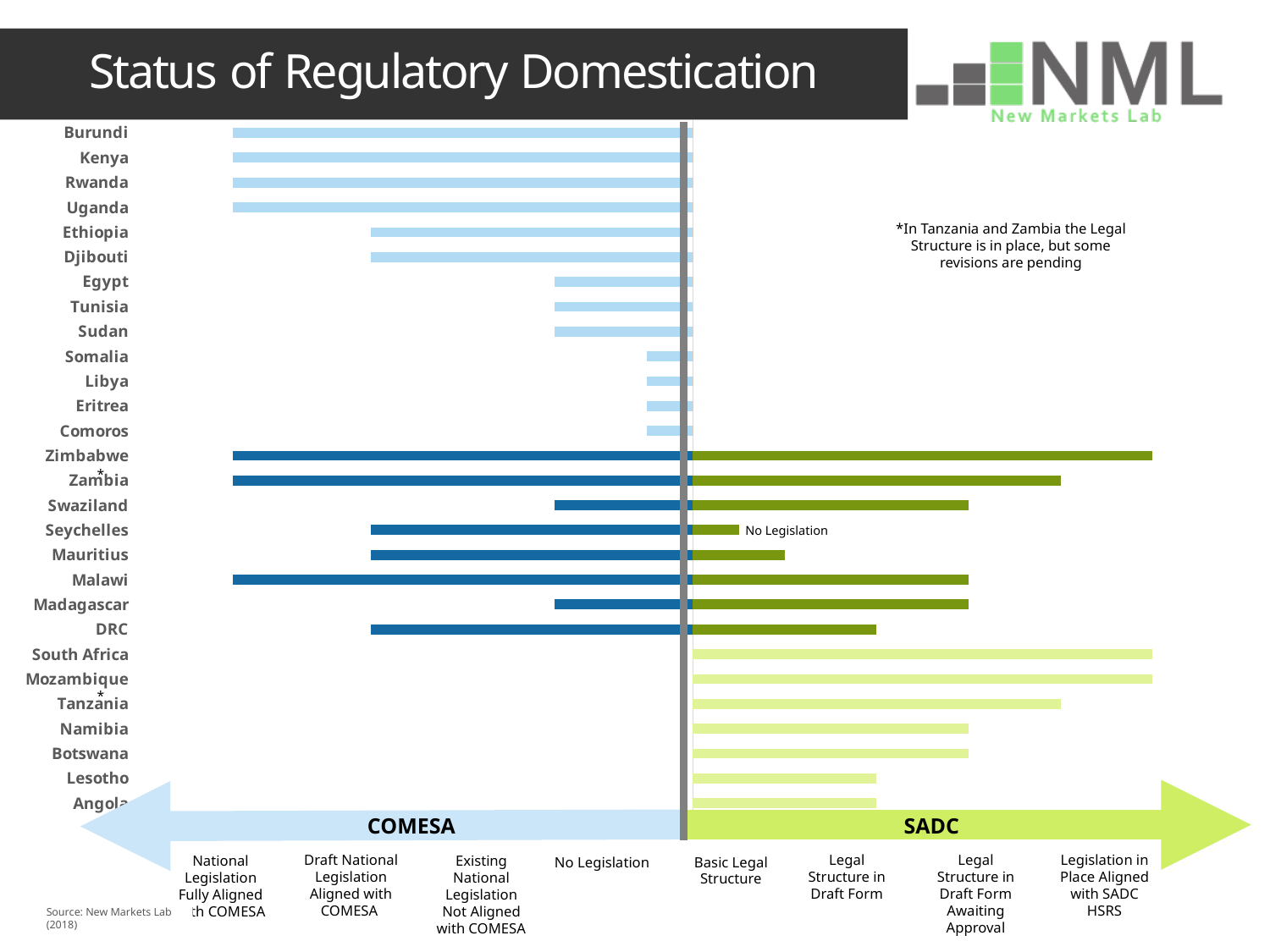
What COMESA status does Comoros's bar reach? No Legislation What COMESA status does Egypt's bar reach? Existing National Legislation Not Aligned with COMESA How many countries are listed on the vertical axis of the chart? 28 What kind of chart is shown on the slide? Bar chart What is the title of the chart on the slide? Status of Regulatory Domestication Which two regional groupings are labelled along the bottom of the chart? COMESA and SADC What SADC status does Namibia's bar reach? Legal Structure in Draft Form Awaiting Approval What SADC status does Zimbabwe's bar reach? Legislation in Place Aligned with SADC HSRS What SADC status is labelled next to Seychelles's bar? No Legislation How many countries have bars on both the COMESA and SADC sides of the chart? 8 What COMESA status does Burundi's bar reach? National Legislation Fully Aligned with COMESA What COMESA status does Ethiopia's bar reach? Draft National Legislation Aligned with COMESA